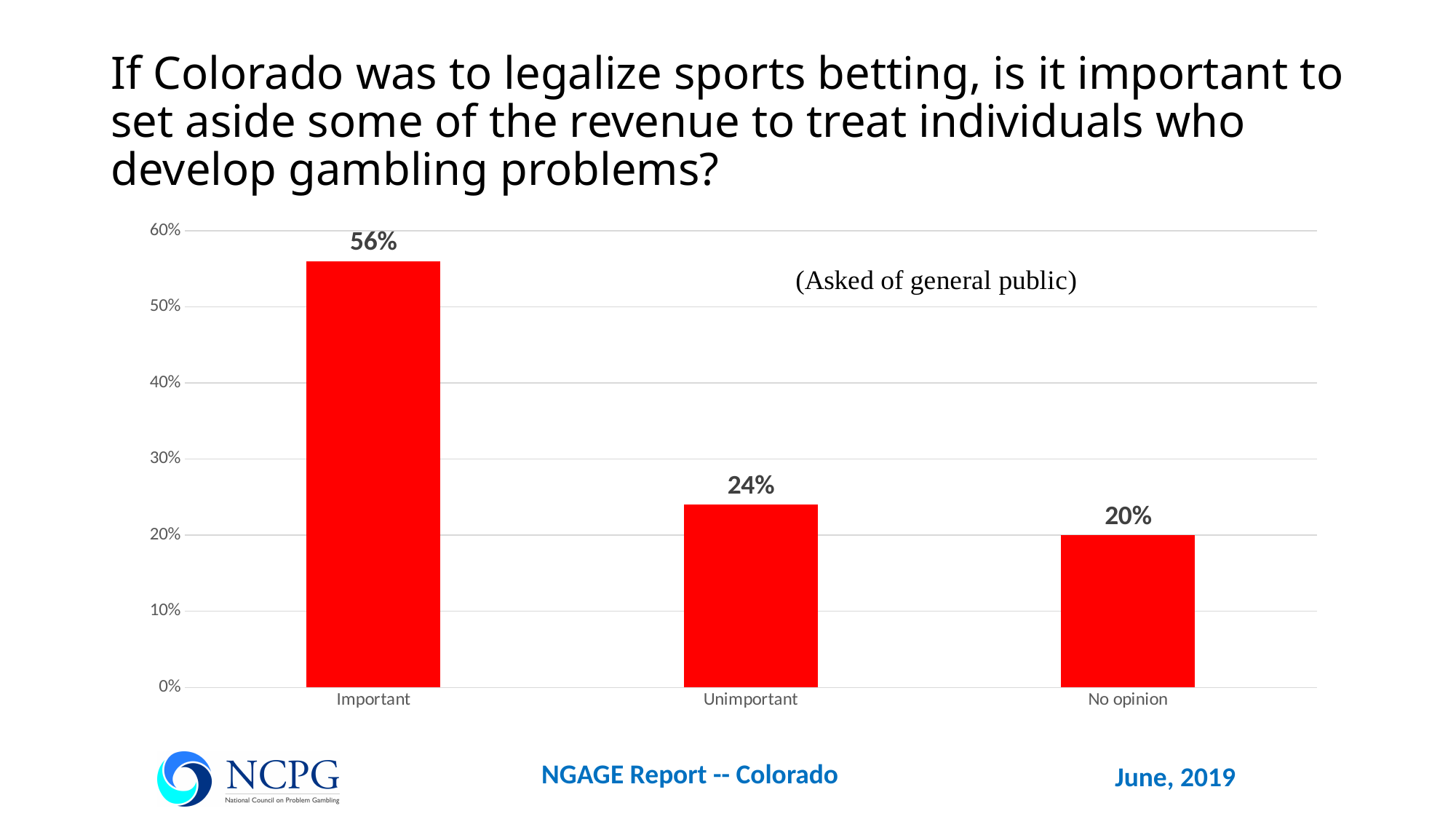
What is the difference between the Important and Unimportant values? 32% Which category has the highest value? Important What is the value shown for the Unimportant category? 24% What is the value shown for the No opinion category? 20% How many categories are shown on the chart? 3 What percentage of respondents said it is important to set aside revenue to treat gambling problems? 56% What colour are the bars in the chart? Red Is the value for Important greater or less than 50%? greater What is the difference between the Unimportant and No opinion values? 4% What kind of chart is shown on the slide? Bar chart Which is larger, the value for Unimportant or the value for No opinion? Unimportant Which category has the lowest value? No opinion